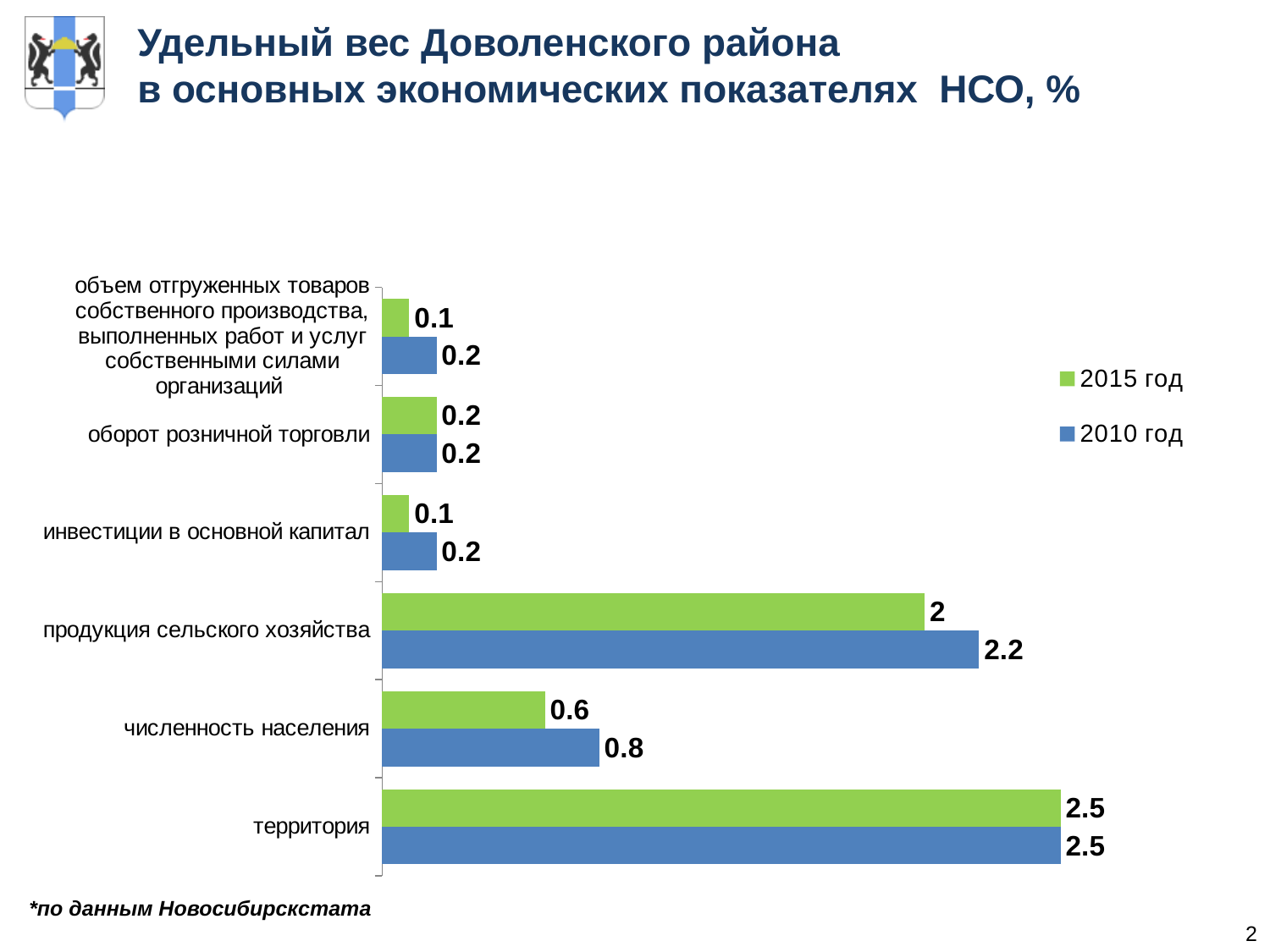
What is the value for инвестиции в основной капитал in 2010 год? 0.2 What is the value for численность населения in 2010 год? 0.8 What is the value for продукция сельского хозяйства in 2015 год? 2 What kind of chart is shown on the slide? bar chart Which is larger for продукция сельского хозяйства: the 2010 год value or the 2015 год value? 2010 год How many series does the legend list? 2 How many categories are shown on the chart? 6 What is the difference between the 2010 год and 2015 год values for численность населения? 0.2 What is the value for территория in 2015 год? 2.5 Which category has the highest value in 2010 год? территория Which colour represents 2015 год in the chart? green